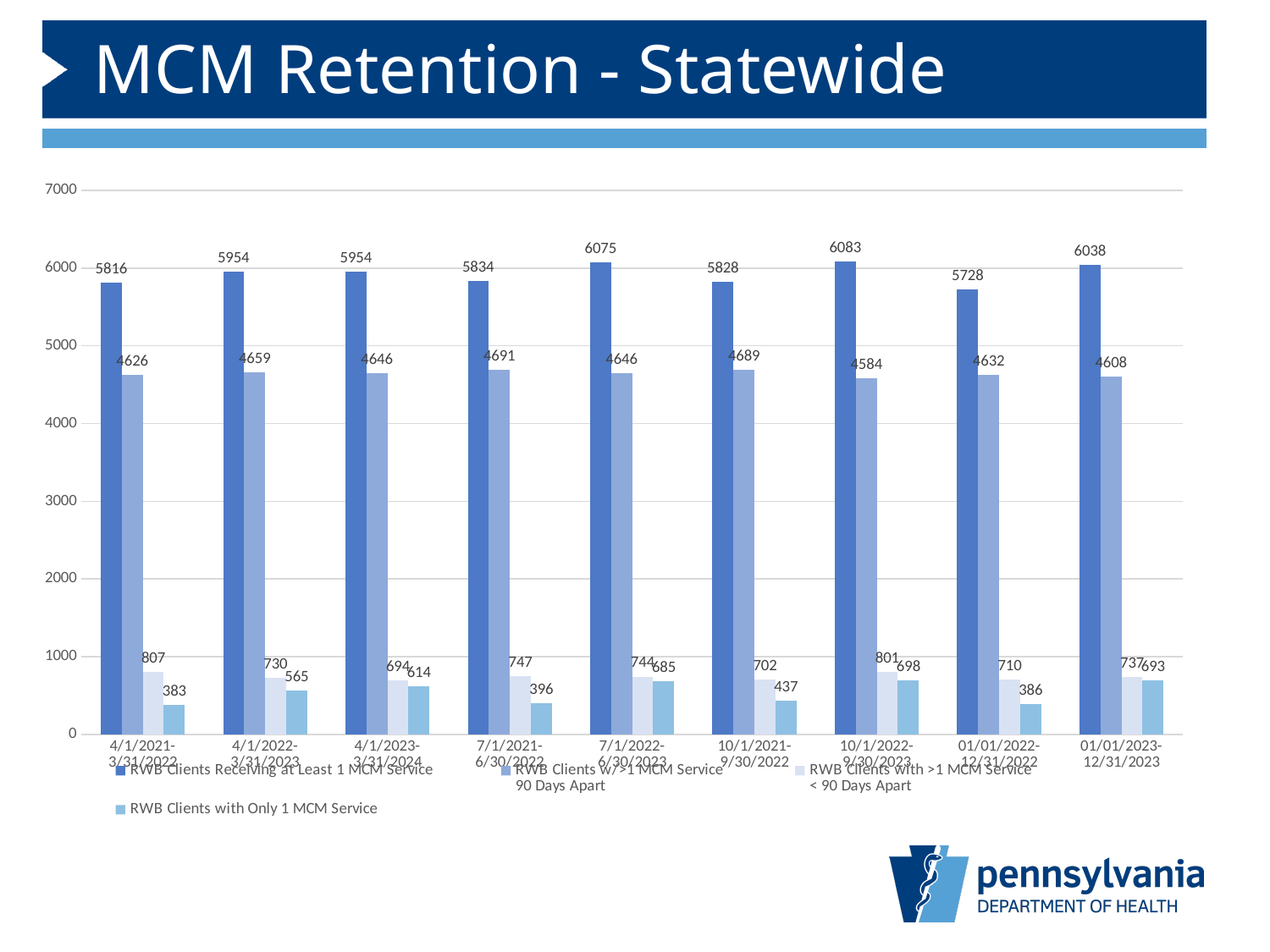
Which is larger in the 4/1/2023-3/31/2024 period: RWB Clients with >1 MCM Service < 90 Days Apart or RWB Clients with Only 1 MCM Service? RWB Clients with >1 MCM Service < 90 Days Apart What kind of chart is shown on the slide? Bar chart What is the difference between RWB Clients Receiving at Least 1 MCM Service and RWB Clients w/ >1 MCM Service 90 Days Apart in the 4/1/2021-3/31/2022 period? 1190 Which period has the lowest value for RWB Clients with Only 1 MCM Service? 4/1/2021-3/31/2022 Is the value for RWB Clients Receiving at Least 1 MCM Service in the 7/1/2022-6/30/2023 period greater or less than 6000? greater What is the value for RWB Clients Receiving at Least 1 MCM Service in the 4/1/2021-3/31/2022 period? 5816 How many time periods are shown on the x axis? 9 What is the value for RWB Clients w/ >1 MCM Service 90 Days Apart in the 01/01/2023-12/31/2023 period? 4608 What is the value for RWB Clients with Only 1 MCM Service in the 7/1/2022-6/30/2023 period? 685 Which period has the lowest value for RWB Clients Receiving at Least 1 MCM Service? 01/01/2022-12/31/2022 How many series does the legend list? 4 Which period has the highest value for RWB Clients Receiving at Least 1 MCM Service? 10/1/2022-9/30/2023